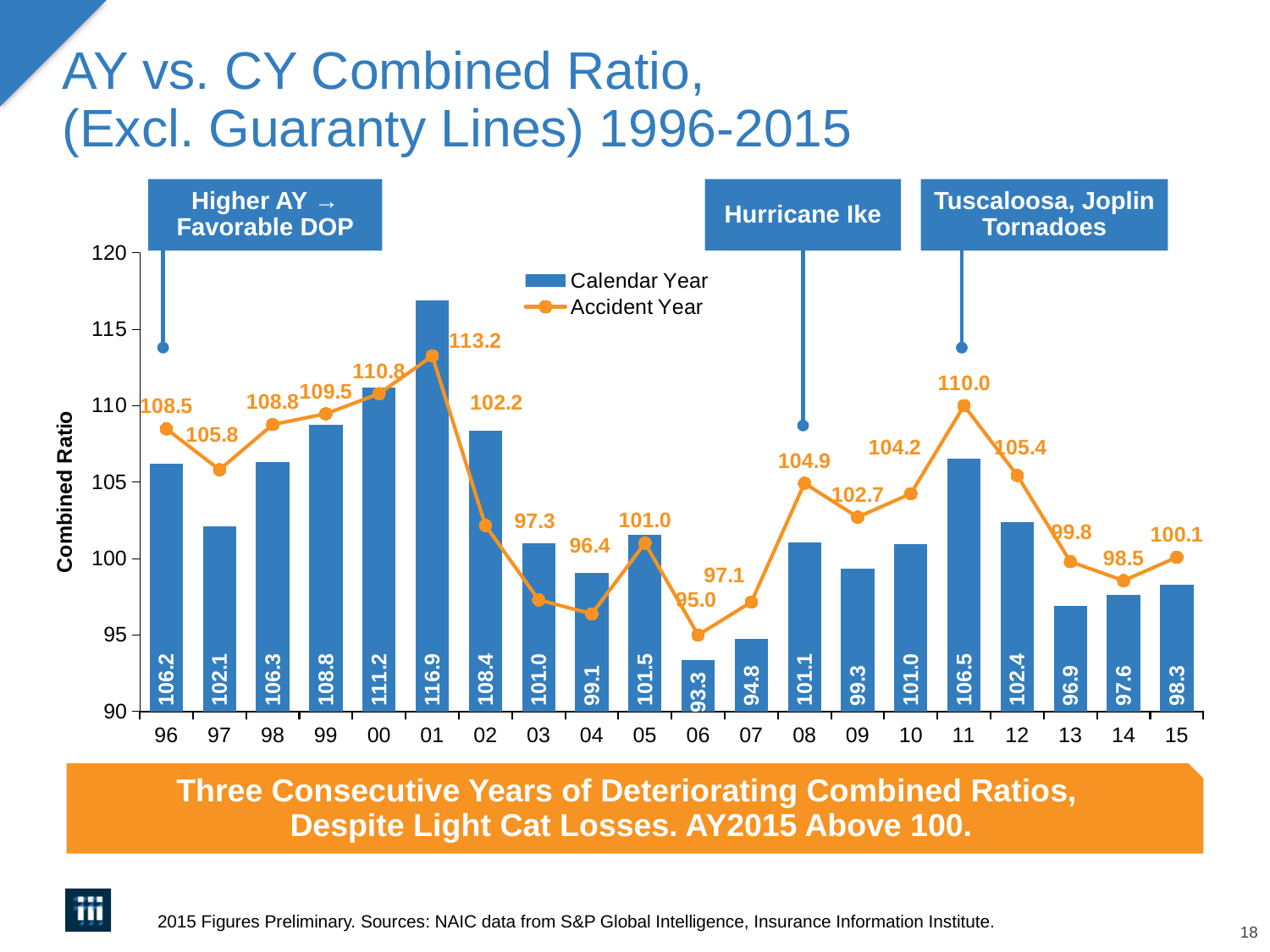
Does the Calendar Year combined ratio rise or fall from 2013 to 2015? rise How many years are shown on the x axis? 20 What is the Accident Year combined ratio for 2015? 100.1 Which year has the highest Calendar Year combined ratio? 01 What is the difference between the Accident Year and Calendar Year combined ratios in 2015? 1.8 What is the Calendar Year combined ratio for 2006? 93.3 What event is annotated above the 2008 data point? Hurricane Ike What is the difference between the Calendar Year combined ratio in 2001 and in 2006? 23.6 What is the Calendar Year combined ratio for 2001? 116.9 How many series does the legend list? 2 Which is larger in 2008, the Calendar Year or the Accident Year combined ratio? Accident Year Which year has the lowest Accident Year combined ratio? 06